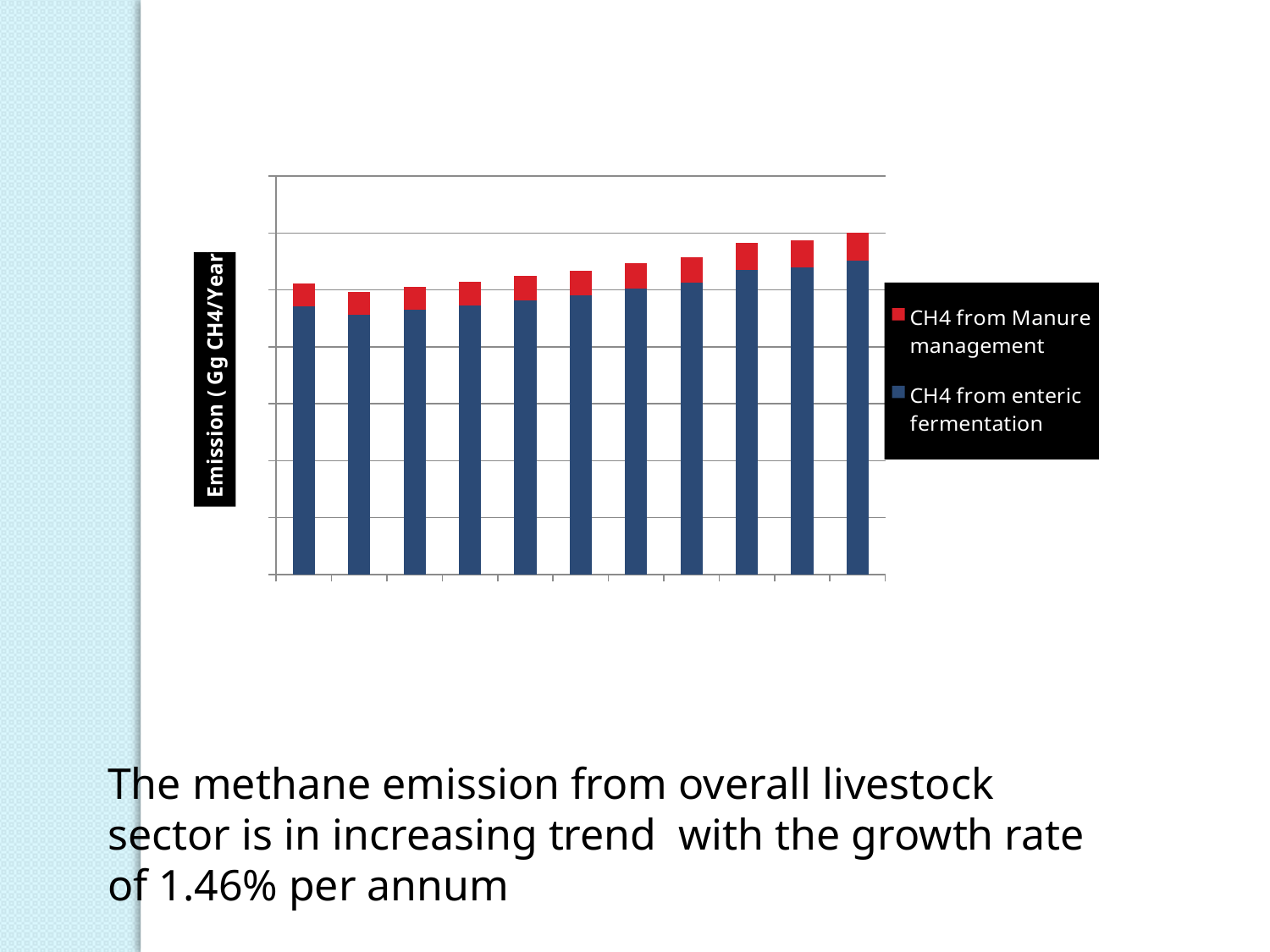
Do the total emissions generally rise or fall from left to right across the bars? Rise Which series contributes the larger portion of each stacked bar, CH4 from Manure management or CH4 from enteric fermentation? CH4 from enteric fermentation How many series does the legend list? 2 What is the label on the vertical axis of the chart? Emission ( Gg CH4/Year How many bars are plotted in the chart? 11 What type of chart is shown on the slide? Stacked bar chart Which bar has the highest total emission, the leftmost or the rightmost? The rightmost What colour represents CH4 from Manure management in the chart? Red